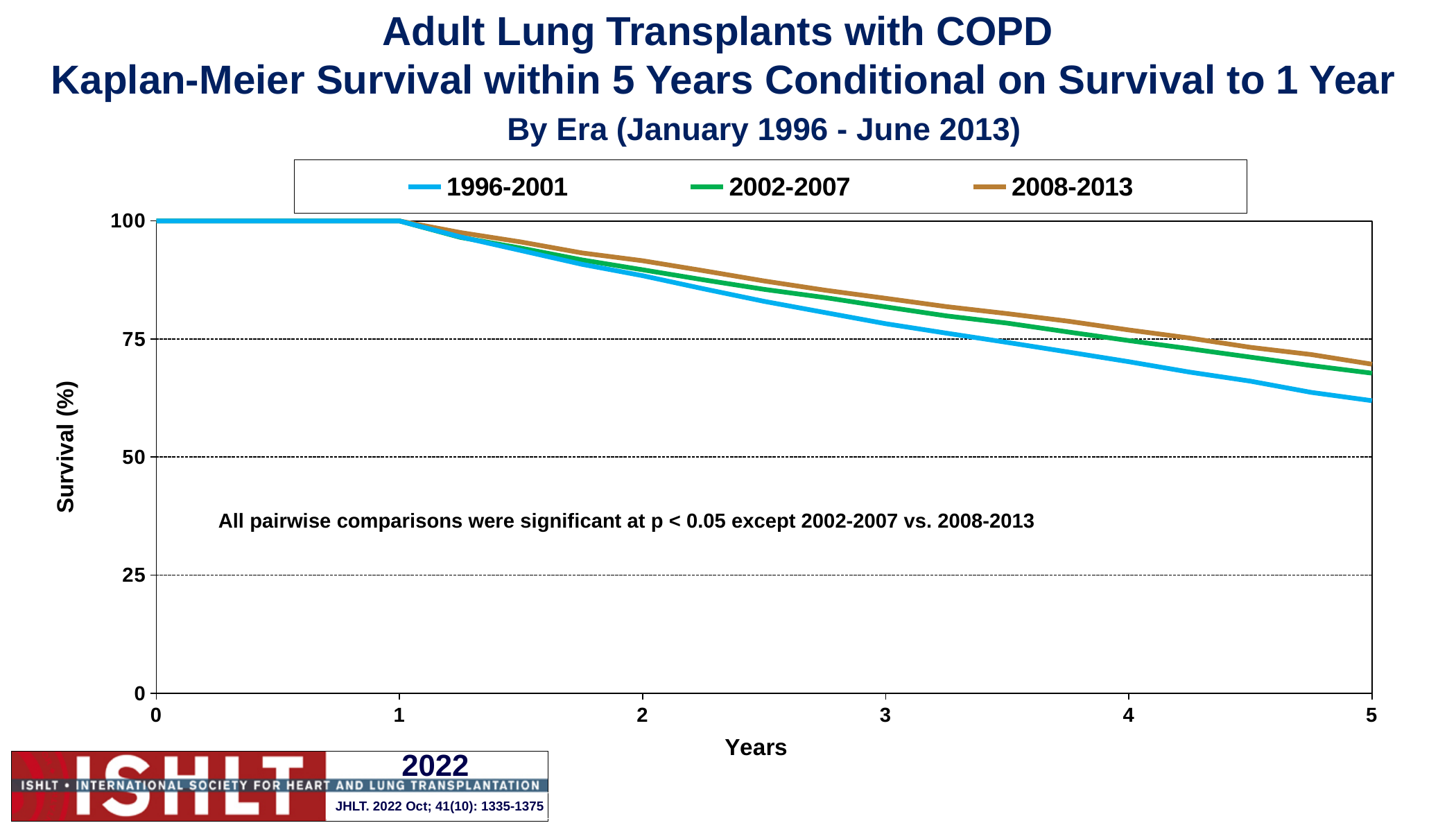
Is the survival value for 2008-2013 at year 5 greater or less than 75? less How many series does the legend list? 3 Is the survival value for 1996-2001 at year 5 greater or less than 75? less What is the survival value for the 1996-2001 series at year 1? 100 At year 5, which series has the higher survival, 1996-2001 or 2008-2013? 2008-2013 What kind of chart is shown on the slide? line chart Is the survival value for 2002-2007 at year 2 greater or less than 75? greater What is the survival value for the 2008-2013 series at year 0? 100 Do the survival values rise or fall along the x axis after year 1? fall Which series has the lowest survival at year 5? 1996-2001 Which colour represents the 2002-2007 series in the legend? green What is the label of the y axis? Survival (%)